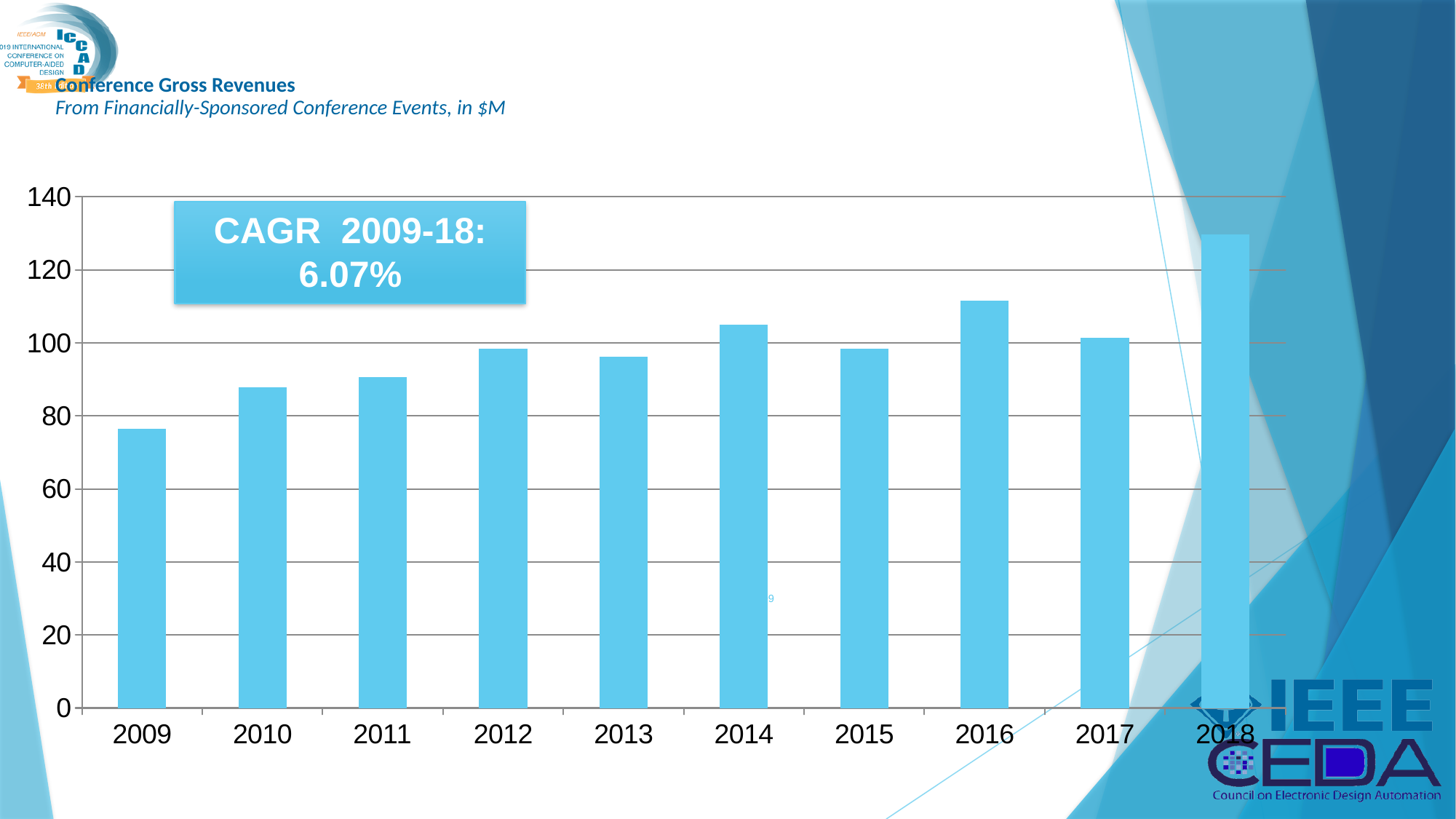
Is the value for 2018 greater or less than 120? greater Do the values generally rise or fall from 2009 to 2018? rise Which year has the lowest conference gross revenue? 2009 How many years are shown on the x axis of the chart? 10 Which year has the highest conference gross revenue? 2018 What CAGR for 2009-18 is stated in the box on the chart? 6.07% Which year has the larger value, 2014 or 2016? 2016 Which year has the larger value, 2009 or 2010? 2010 Is the value for 2016 greater or less than 100? greater Is the value for 2011 greater or less than 100? less What kind of chart is shown on the slide? bar chart